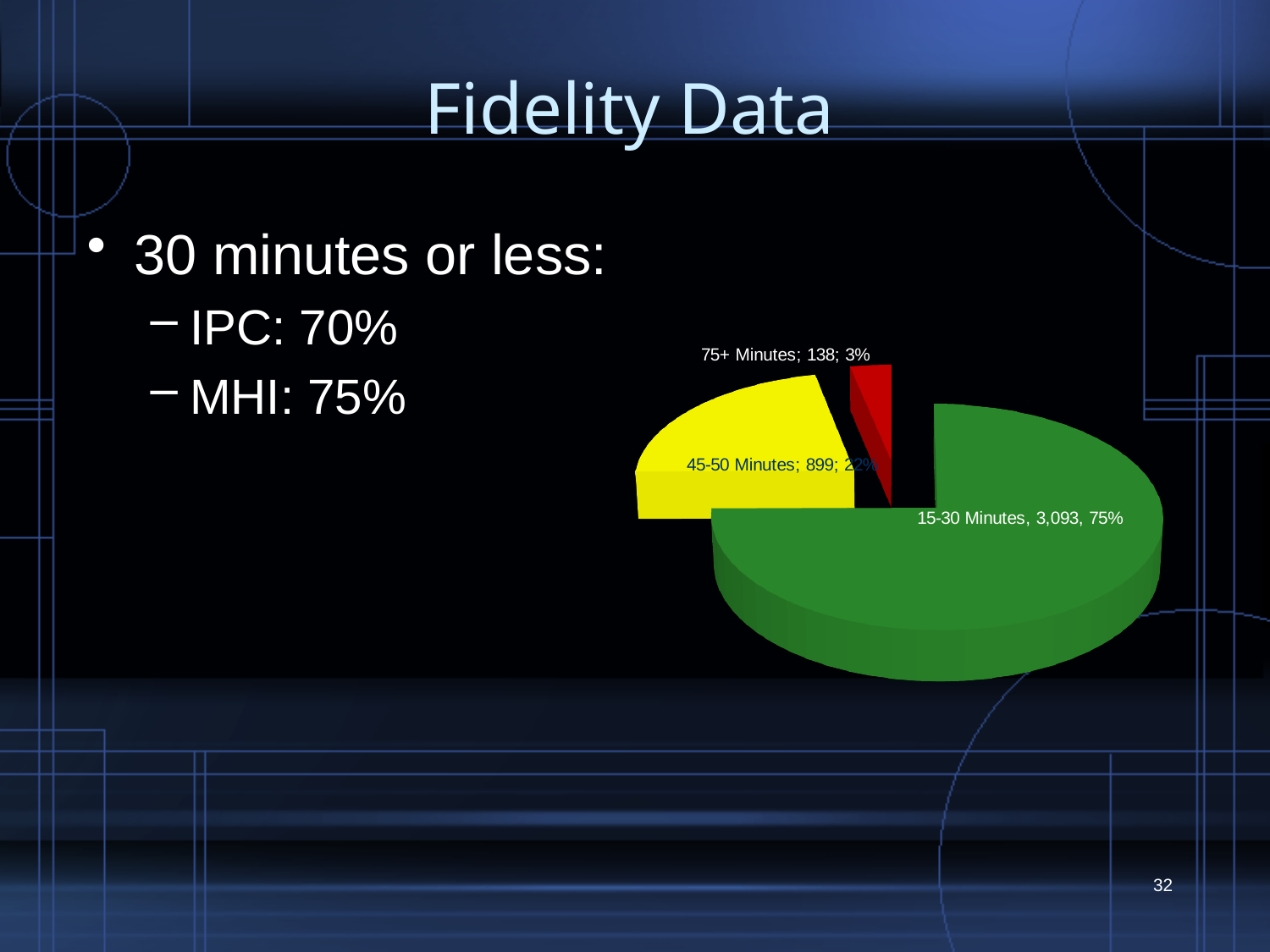
What share of the pie does the 15-30 Minutes slice represent? 75% What is the value for the 45-50 Minutes slice? 899 Which slice is larger, 45-50 Minutes or 75+ Minutes? 45-50 Minutes Which slice of the pie chart is the largest? 15-30 Minutes What is the value for the 15-30 Minutes slice? 3,093 What is the difference between the values for 45-50 Minutes and 75+ Minutes? 761 Which slice of the pie chart is the smallest? 75+ Minutes What share of the pie does the 45-50 Minutes slice represent? 22% What kind of chart is shown on the slide? pie chart What share of the pie does the 75+ Minutes slice represent? 3% How many slices does the pie chart have? 3 What is the value for the 75+ Minutes slice? 138